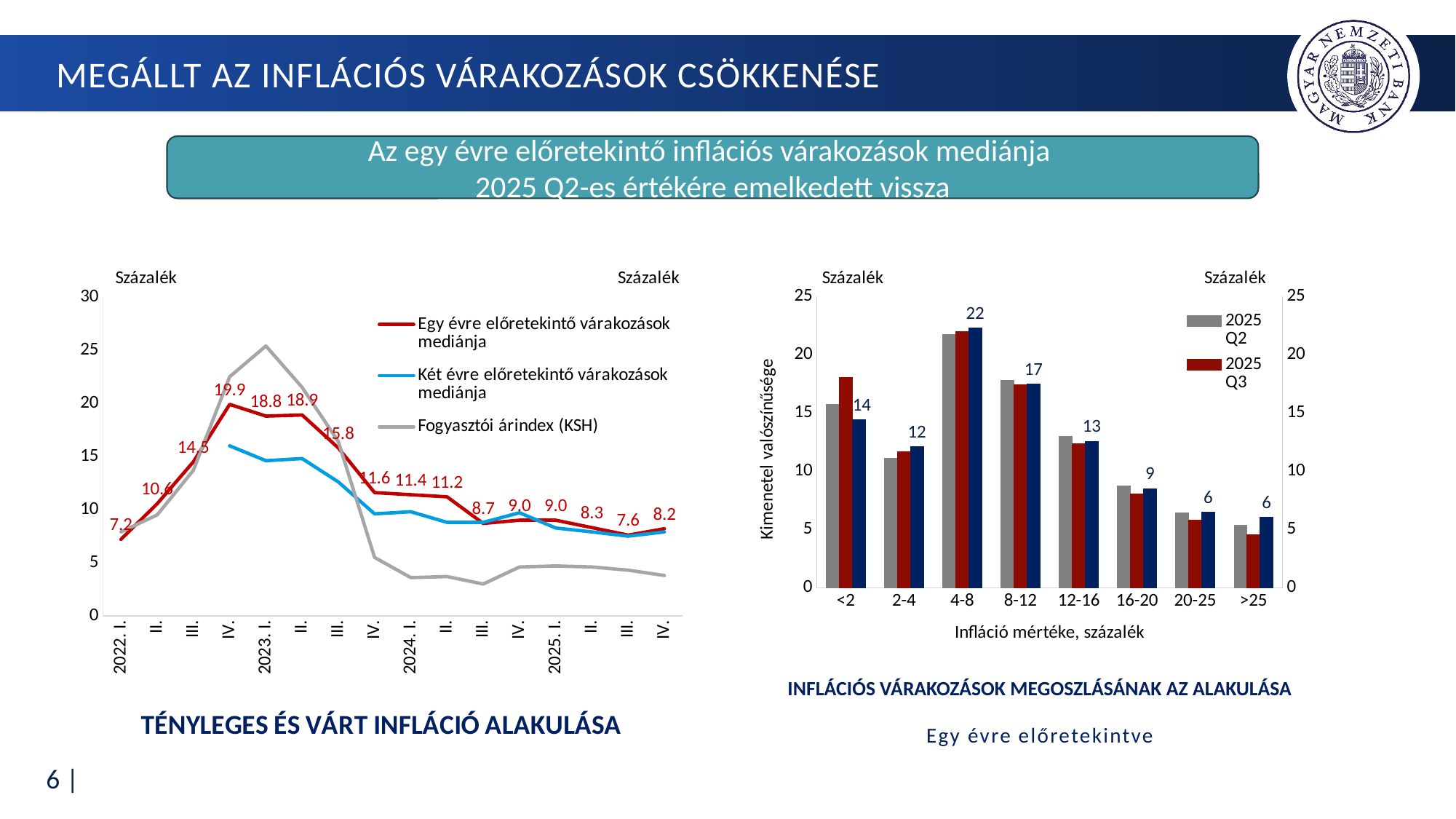
In the chart titled 'INFLÁCIÓS VÁRAKOZÁSOK MEGOSZLÁSÁNAK AZ ALAKULÁSA', how many inflation categories are shown on the x axis? 8 In the chart titled 'INFLÁCIÓS VÁRAKOZÁSOK MEGOSZLÁSÁNAK AZ ALAKULÁSA', is the 2025 Q2 value for the 16-20 category greater or less than 10? less What kind of chart is 'TÉNYLEGES ÉS VÁRT INFLÁCIÓ ALAKULÁSA'? line chart In the chart titled 'TÉNYLEGES ÉS VÁRT INFLÁCIÓ ALAKULÁSA', what is the value of 'Egy évre előretekintő várakozások mediánja' at 2025 IV.? 8.2 In the chart titled 'TÉNYLEGES ÉS VÁRT INFLÁCIÓ ALAKULÁSA', how many series does the legend list? 3 In the chart titled 'TÉNYLEGES ÉS VÁRT INFLÁCIÓ ALAKULÁSA', by how much does 'Egy évre előretekintő várakozások mediánja' change from 2025 III. to 2025 IV.? 0.6 In the chart titled 'INFLÁCIÓS VÁRAKOZÁSOK MEGOSZLÁSÁNAK AZ ALAKULÁSA', which inflation category has the highest bars? 4-8 In the chart titled 'TÉNYLEGES ÉS VÁRT INFLÁCIÓ ALAKULÁSA', is the value of 'Fogyasztói árindex (KSH)' at 2023 I. greater or less than 20? greater In the chart titled 'TÉNYLEGES ÉS VÁRT INFLÁCIÓ ALAKULÁSA', at which quarter does 'Egy évre előretekintő várakozások mediánja' reach its highest value? 2022 IV. In the chart titled 'TÉNYLEGES ÉS VÁRT INFLÁCIÓ ALAKULÁSA', what is the lowest labelled value of 'Egy évre előretekintő várakozások mediánja'? 7.2 In the chart titled 'TÉNYLEGES ÉS VÁRT INFLÁCIÓ ALAKULÁSA', what is the value of 'Egy évre előretekintő várakozások mediánja' at 2022 IV.? 19.9 What kind of chart is 'INFLÁCIÓS VÁRAKOZÁSOK MEGOSZLÁSÁNAK AZ ALAKULÁSA'? bar chart